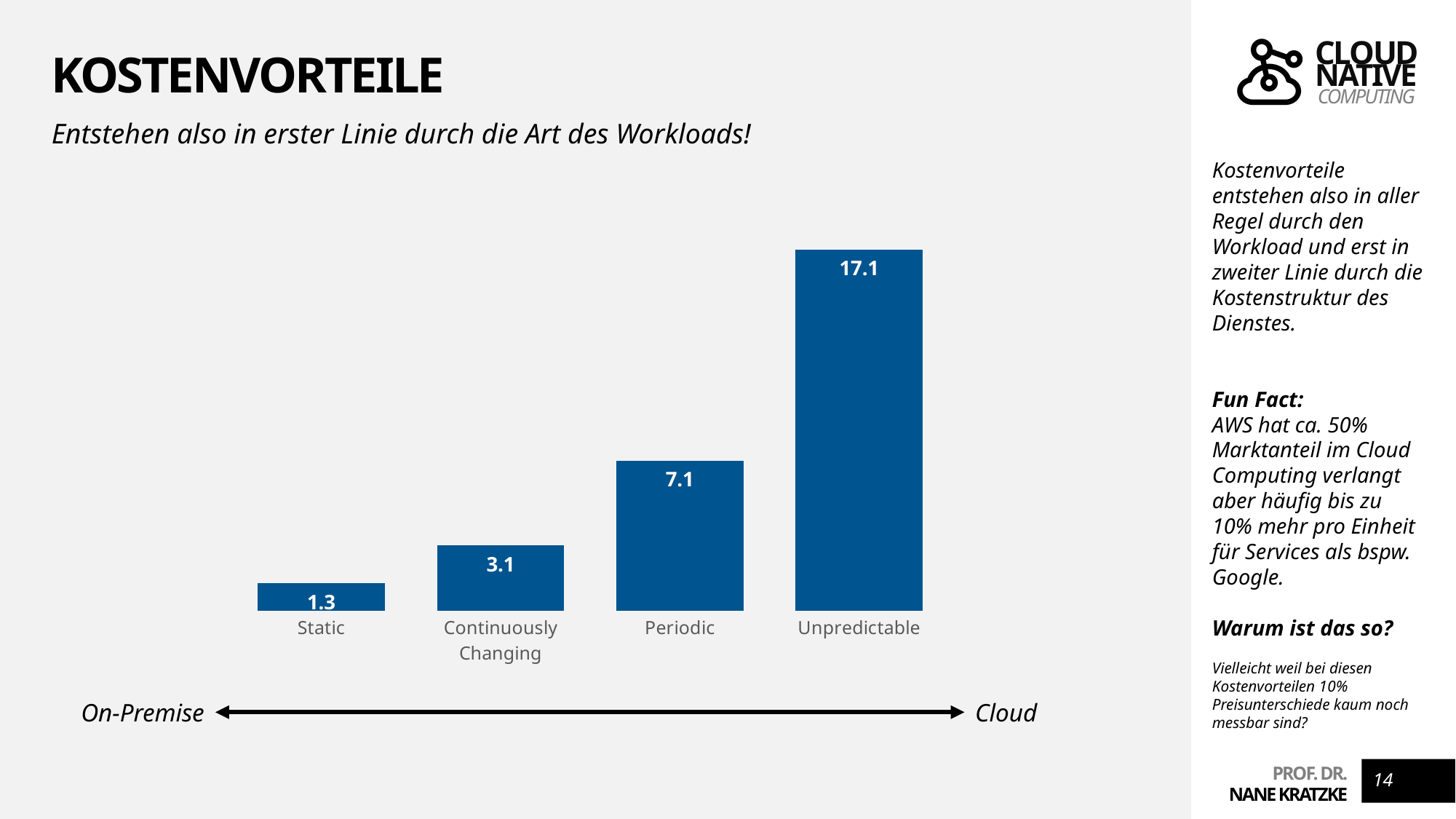
Which category has the lowest value? Static What kind of chart is shown on the slide? Bar chart Which is larger, the value for Periodic or the value for Continuously Changing? Periodic Which category has the highest value? Unpredictable Do the values rise or fall from Static to Unpredictable along the x axis? Rise What is the value for Static? 1.3 How many categories are shown in the chart? 4 What is the value for Continuously Changing? 3.1 What is the difference between the values for Unpredictable and Periodic? 10.0 What is the value for Unpredictable? 17.1 What is the difference between the values for Continuously Changing and Static? 1.8 What is the value for Periodic? 7.1